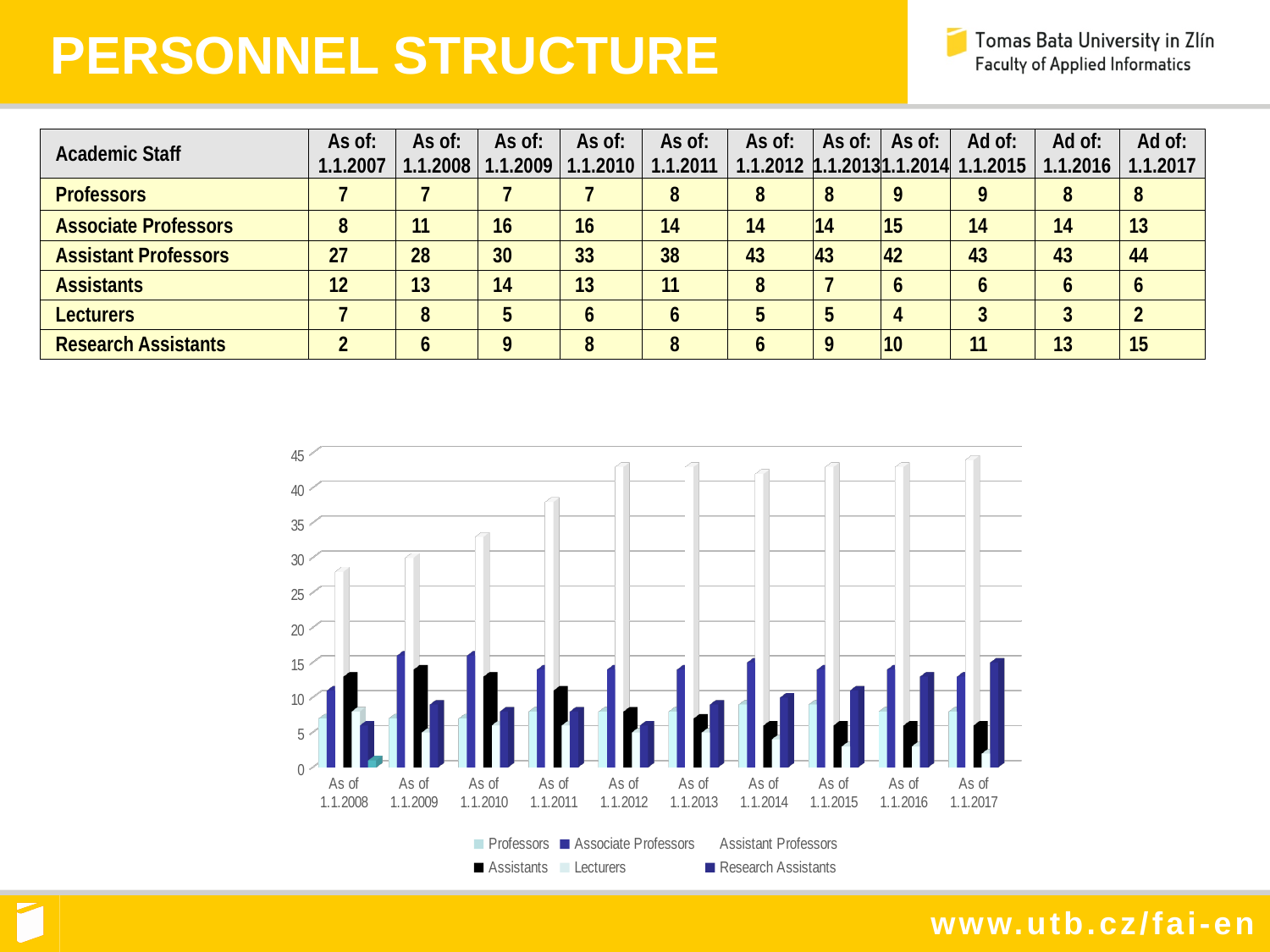
How many year groups are plotted along the x axis of the chart? 10 What kind of chart is shown on the slide? bar chart As of 1.1.2017, which is larger: Research Assistants or Lecturers? Research Assistants Do the Research Assistants values rise or fall from 1.1.2013 to 1.1.2017? rise What is the number of Professors as of 1.1.2014? 9 Is the value for Assistants as of 1.1.2015 greater or less than 10? less Which series is listed first in the chart's legend? Professors How many series does the chart's legend list? 6 What is the difference between the number of Assistant Professors as of 1.1.2017 and as of 1.1.2008? 16 In the 'As of 1.1.2017' group, which series has the shortest bar? Lecturers Which series has the tallest bar in every year group of the chart? Assistant Professors Is the value for Assistant Professors as of 1.1.2012 greater or less than 40? greater